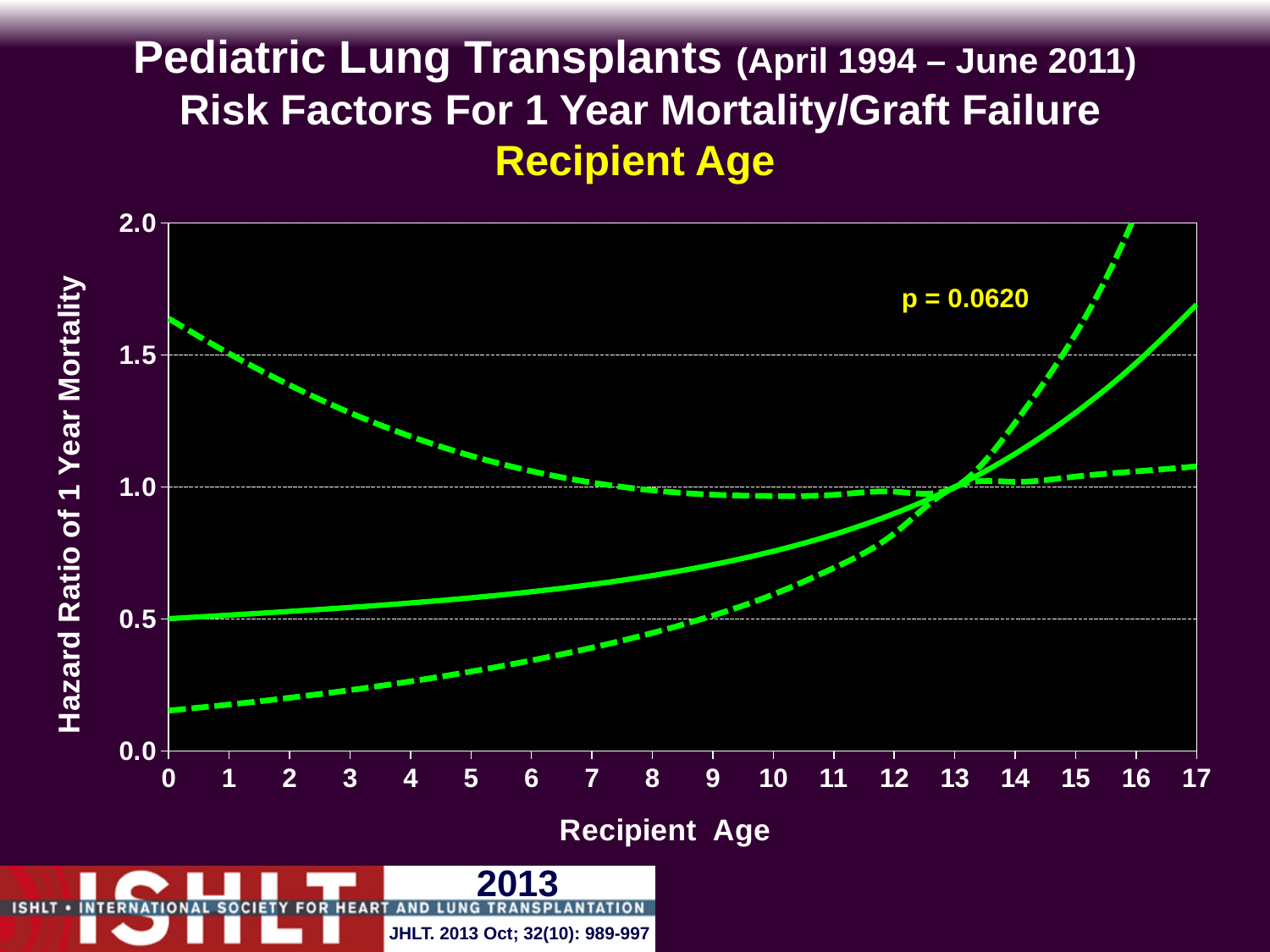
Does the solid line rise or fall as recipient age increases from 0 to 17? rise Is the value of the solid line at recipient age 17 greater or less than 1.5? greater Is the value of the lower dashed line at recipient age 0 greater or less than 0.5? less How many lines are plotted on the chart? 3 What is the label of the y axis? Hazard Ratio of 1 Year Mortality Is the value of the solid line at recipient age 5 greater or less than 1.0? less What kind of chart is shown on the slide? line chart What is the p-value printed on the chart? p = 0.0620 At what recipient age does the solid line cross the hazard ratio of 1.0? 13 How many recipient age tick marks are labelled on the x axis? 18